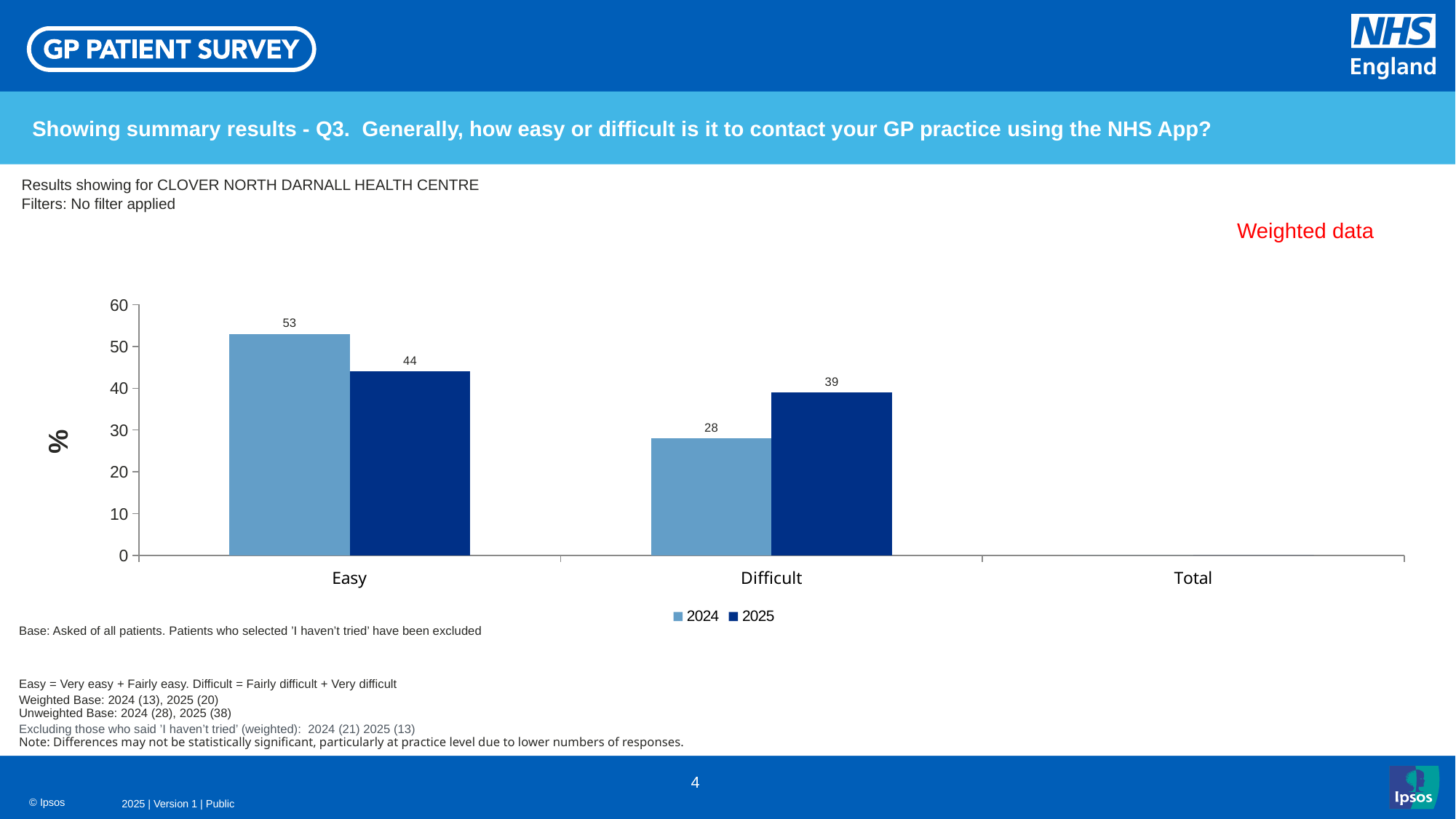
What is the difference between the 2024 and 2025 values for Easy? 9 What is the value for Easy in 2024? 53 How many series does the legend list? 2 What kind of chart is shown on the slide? Bar chart Which is larger for Difficult: the 2024 value or the 2025 value? 2025 What is the value for Easy in 2025? 44 What is the difference between the 2025 and 2024 values for Difficult? 11 What are the series names listed in the legend? 2024 and 2025 What is the value for Difficult in 2025? 39 What is the value for Difficult in 2024? 28 Which category has the highest value in the 2024 series? Easy Which category has the lowest value in the 2025 series? Difficult